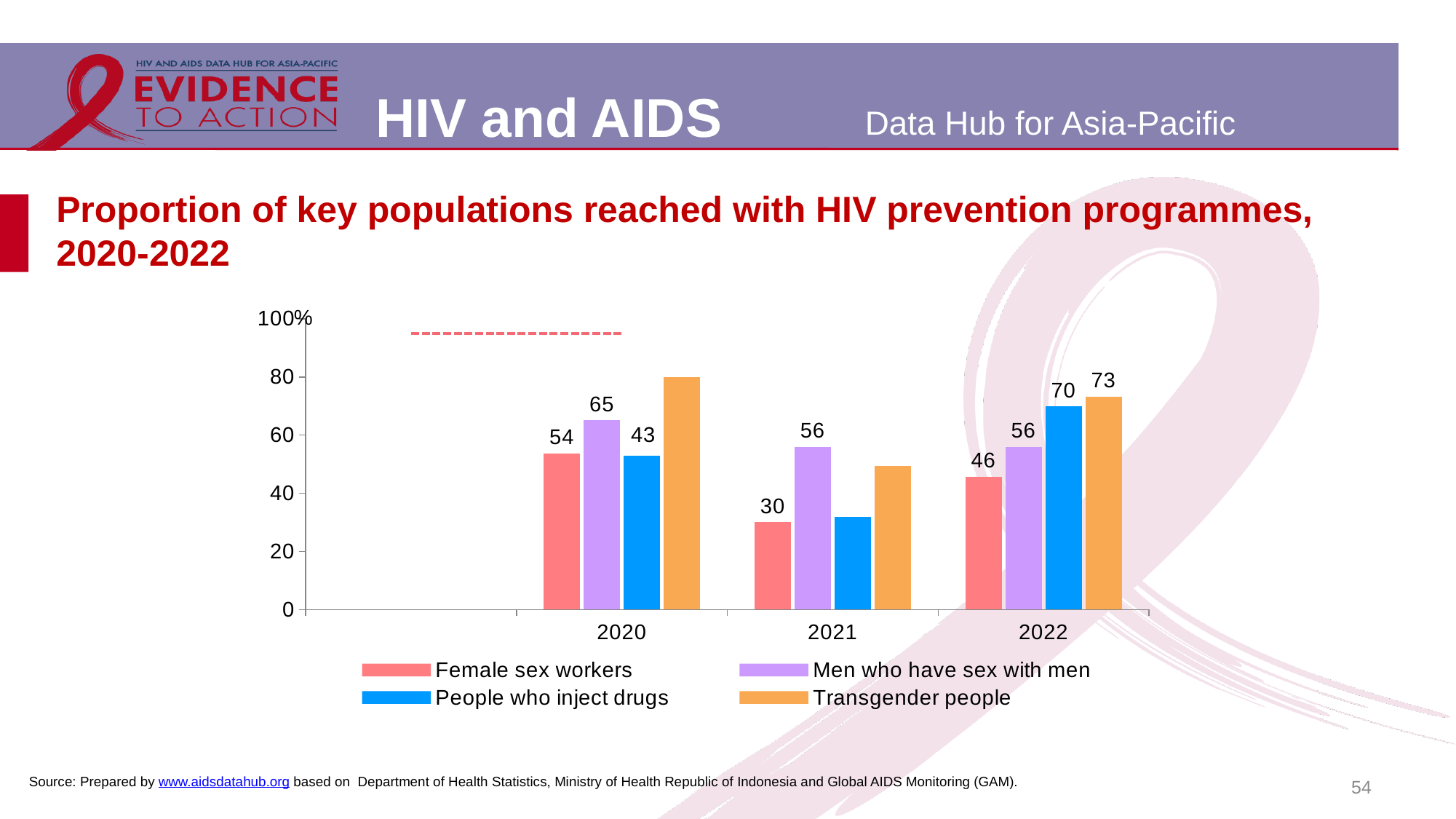
What is the value for Men who have sex with men in 2020? 65 What is the difference between the Female sex workers values in 2020 and 2021? 24 Which key population has the highest value in 2022? Transgender people Which colour represents Transgender people in the legend? orange What is the value for People who inject drugs in 2022? 70 Is the value for Transgender people in 2020 greater or less than 60? greater What is the value for Female sex workers in 2021? 30 How many series does the legend list? 4 What is the value for Transgender people in 2022? 73 What type of chart is shown on the slide? bar chart How many years are shown on the x axis? 3 What is the value for Female sex workers in 2020? 54